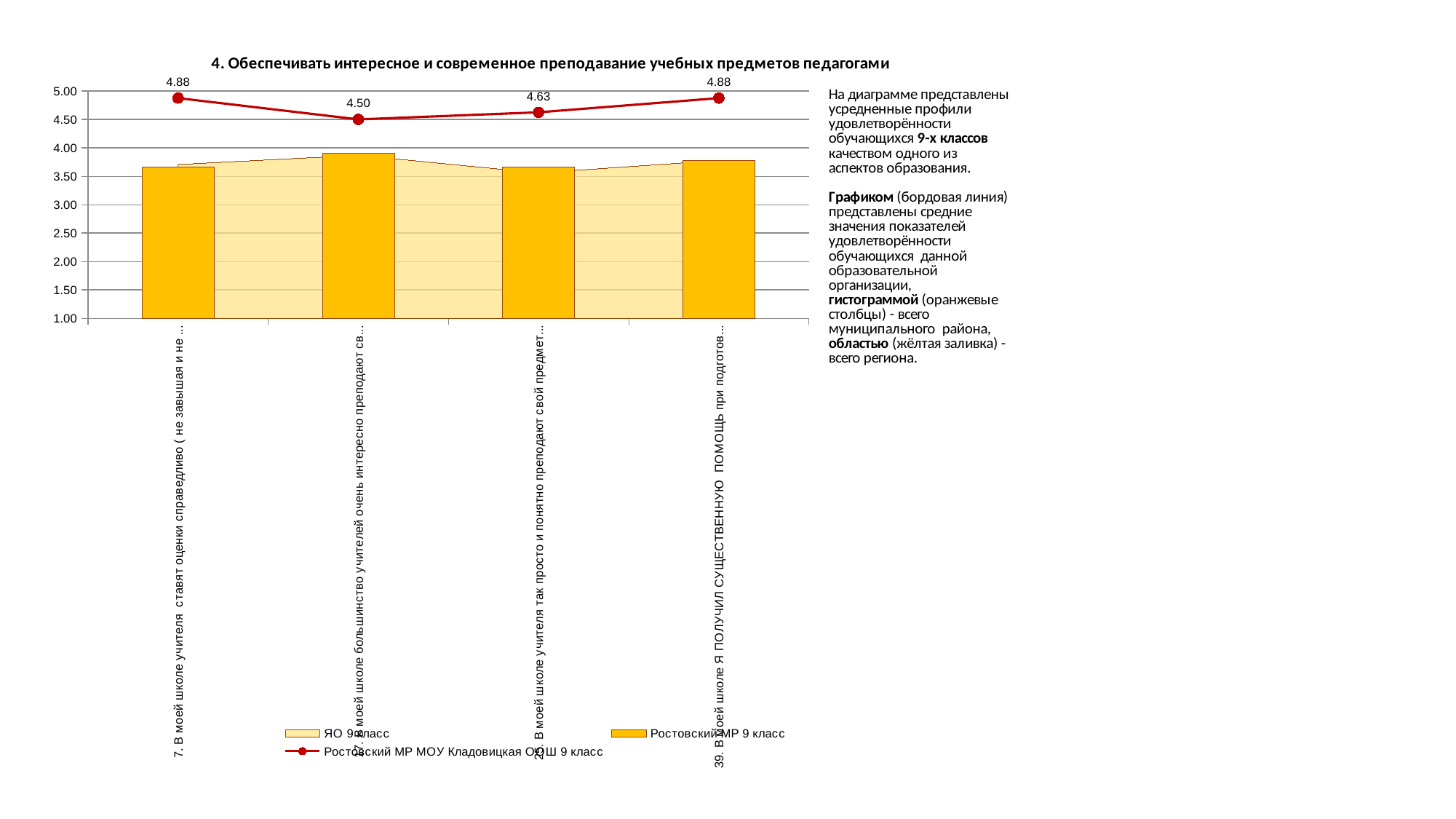
What is the difference between the line series values for the third category and the second category? 0.13 What is the value of the line series for the fourth category (39. В моей школе Я ПОЛУЧИЛ СУЩЕСТВЕННУЮ ПОМОЩЬ...)? 4.88 Is the value of the orange bar (Ростовский МР 9 класс) for the first category greater or less than 4.00? less What is the value of the line series for the third category (...учителя так просто и понятно преподают свой предмет...)? 4.63 What is the value of the line series for the second category (...большинство учителей очень интересно преподают...)? 4.50 Which series is drawn as the dark red line with markers? Ростовский МР МОУ Кладовицкая ООШ 9 класс How many series does the legend list? 3 For which category is the line series (Ростовский МР МОУ Кладовицкая ООШ 9 класс) lowest? The second category (...большинство учителей очень интересно преподают...) What is the value of the line series (Ростовский МР МОУ Кладовицкая ООШ 9 класс) for the first category (7. В моей школе учителя ставят оценки справедливо...)? 4.88 How many categories are shown on the x axis? 4 What is the difference between the line series values for the first category and the second category? 0.38 Is the value of the orange bar (Ростовский МР 9 класс) for the second category greater or less than 3.50? greater